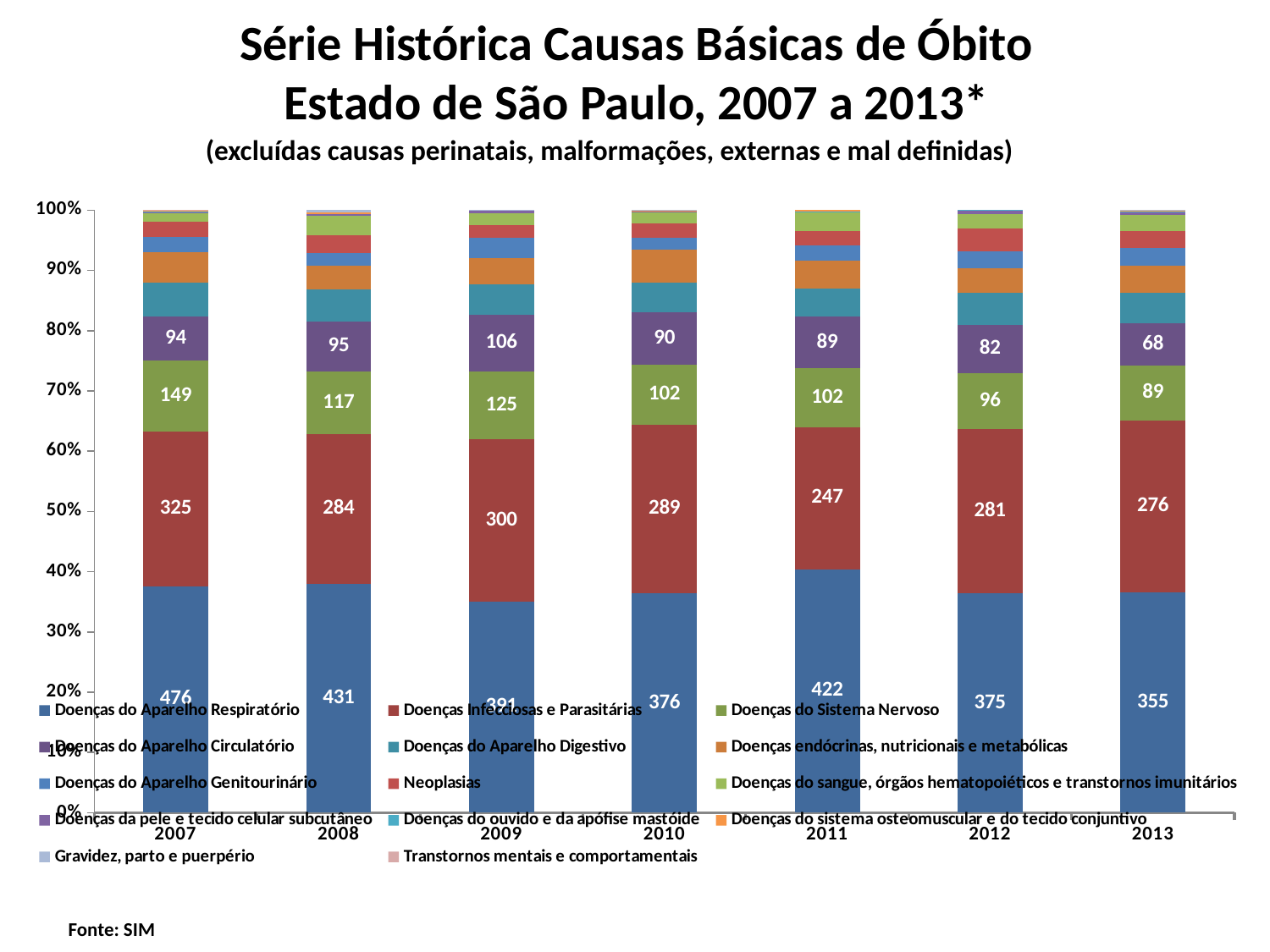
Is the share of Doenças do Aparelho Respiratório in 2007 greater or less than 30%? greater How many years are shown on the x axis? 7 In which year is the value for Doenças do Sistema Nervoso lowest? 2013 What is the value for Doenças Infecciosas e Parasitárias in 2011? 247 What is the value for Doenças do Sistema Nervoso in 2007? 149 What is the value for Doenças do Aparelho Respiratório in 2007? 476 How many series does the legend list? 14 Which year has the larger value for Doenças do Aparelho Respiratório, 2011 or 2012? 2011 What kind of chart is shown on the slide? Stacked bar chart In which year is the value for Doenças do Aparelho Circulatório highest? 2009 What is the difference between the Doenças Infecciosas e Parasitárias values for 2007 and 2013? 49 What is the value for Doenças do Aparelho Circulatório in 2013? 68